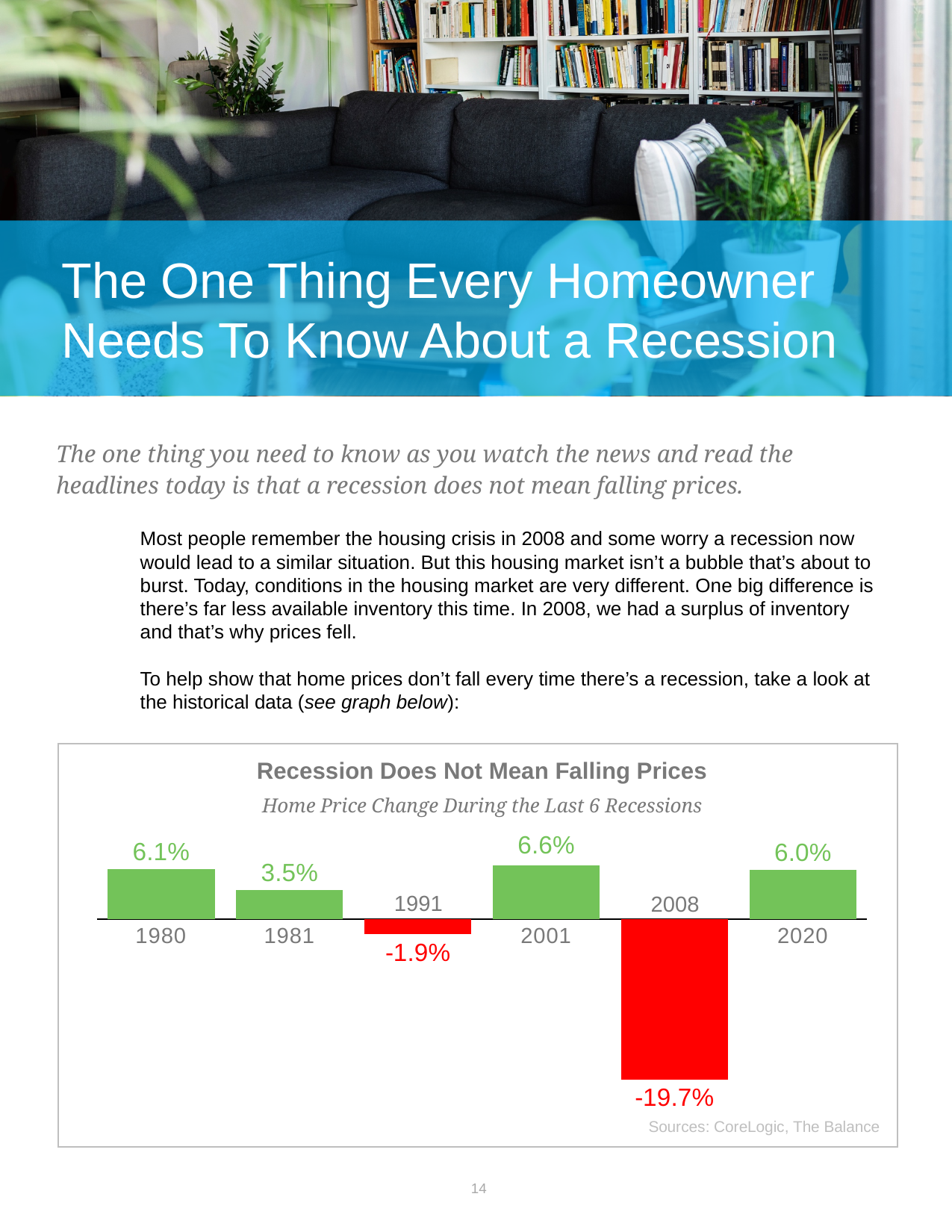
How many recessions are shown in the chart? 6 What is the difference between the home price change in 2001 and in 1981? 3.1% What is the title of the chart? Recession Does Not Mean Falling Prices What was the home price change during the 1991 recession? -1.9% What type of chart is shown on the slide? Bar chart How many of the recessions shown had a negative home price change? 2 Which had a larger home price change, 1980 or 2020? 1980 What was the home price change during the 1980 recession? 6.1% Which recession year shows the lowest home price change? 2008 Which recession year shows the highest home price change? 2001 What was the home price change during the 2008 recession? -19.7% What was the home price change during the 2020 recession? 6.0%